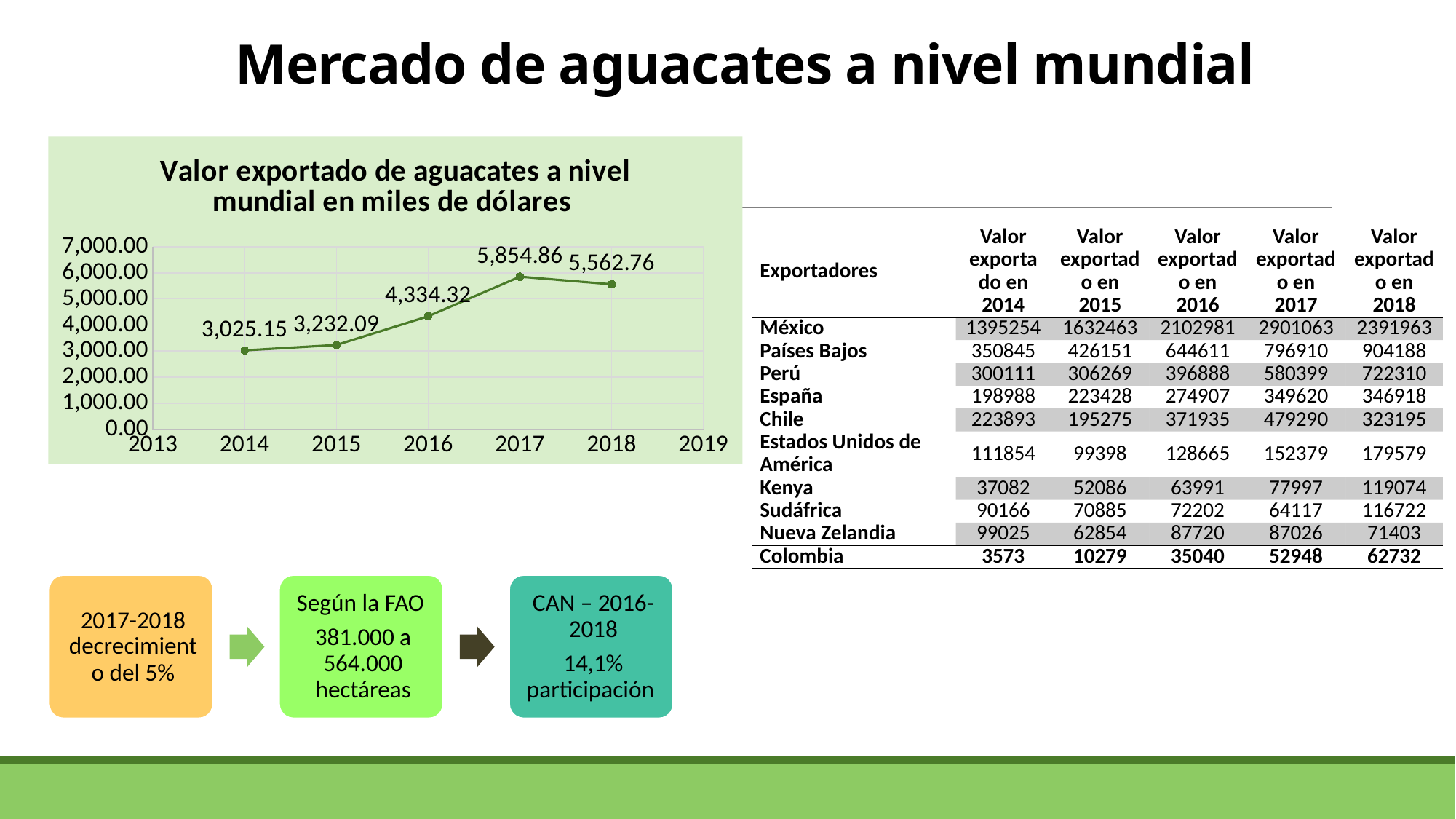
How many data points are plotted on the chart? 5 What is the value exported in 2018 on the chart? 5,562.76 What is the difference between the 2016 and 2015 values on the chart? 1,102.23 Which year has the highest value on the chart? 2017 Which is larger on the chart, the value for 2015 or the value for 2016? 2016 What kind of chart is shown on the slide? line chart What is the title of the chart? Valor exportado de aguacates a nivel mundial en miles de dólares Which year has the lowest value on the chart? 2014 Is the value for 2016 greater or less than 4,000.00? greater What is the difference between the 2017 and 2018 values on the chart? 292.10 What is the value exported in 2017 on the chart? 5,854.86 What is the value exported in 2014 on the chart? 3,025.15